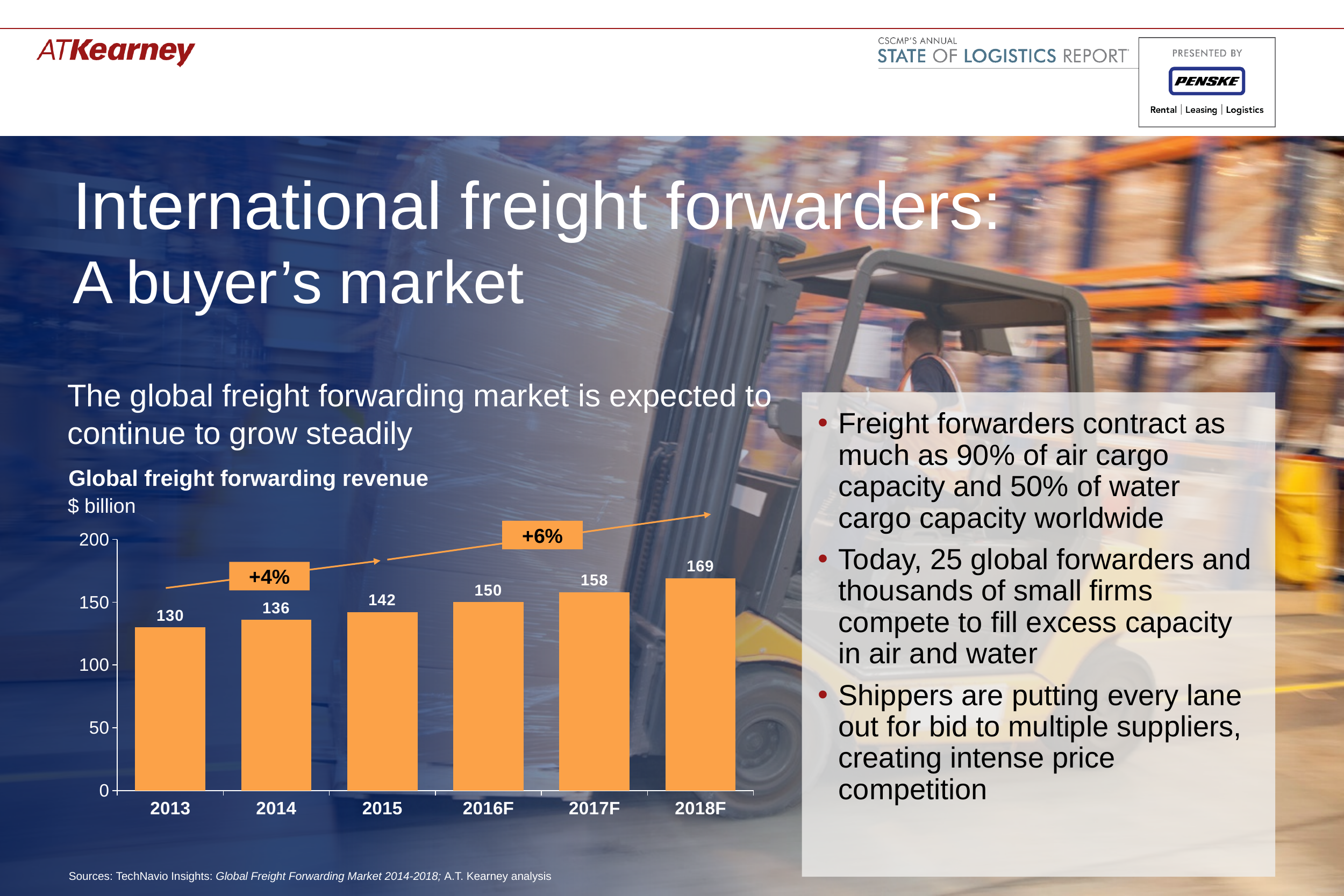
What kind of chart is used to show global freight forwarding revenue? bar chart What is the difference in revenue between 2018F and 2013? 39 How many years are shown on the x axis of the chart? 6 Which is larger, the revenue for 2017F or for 2015? 2017F What is the difference in revenue between 2015 and 2014? 6 What is the global freight forwarding revenue for 2016F? 150 Which year has the highest global freight forwarding revenue? 2018F Do the revenue values rise or fall from 2013 to 2018F? rise Is the value for 2014 greater or less than 150? less What is the global freight forwarding revenue for 2018F? 169 Which year has the lowest global freight forwarding revenue? 2013 What is the global freight forwarding revenue for 2013? 130